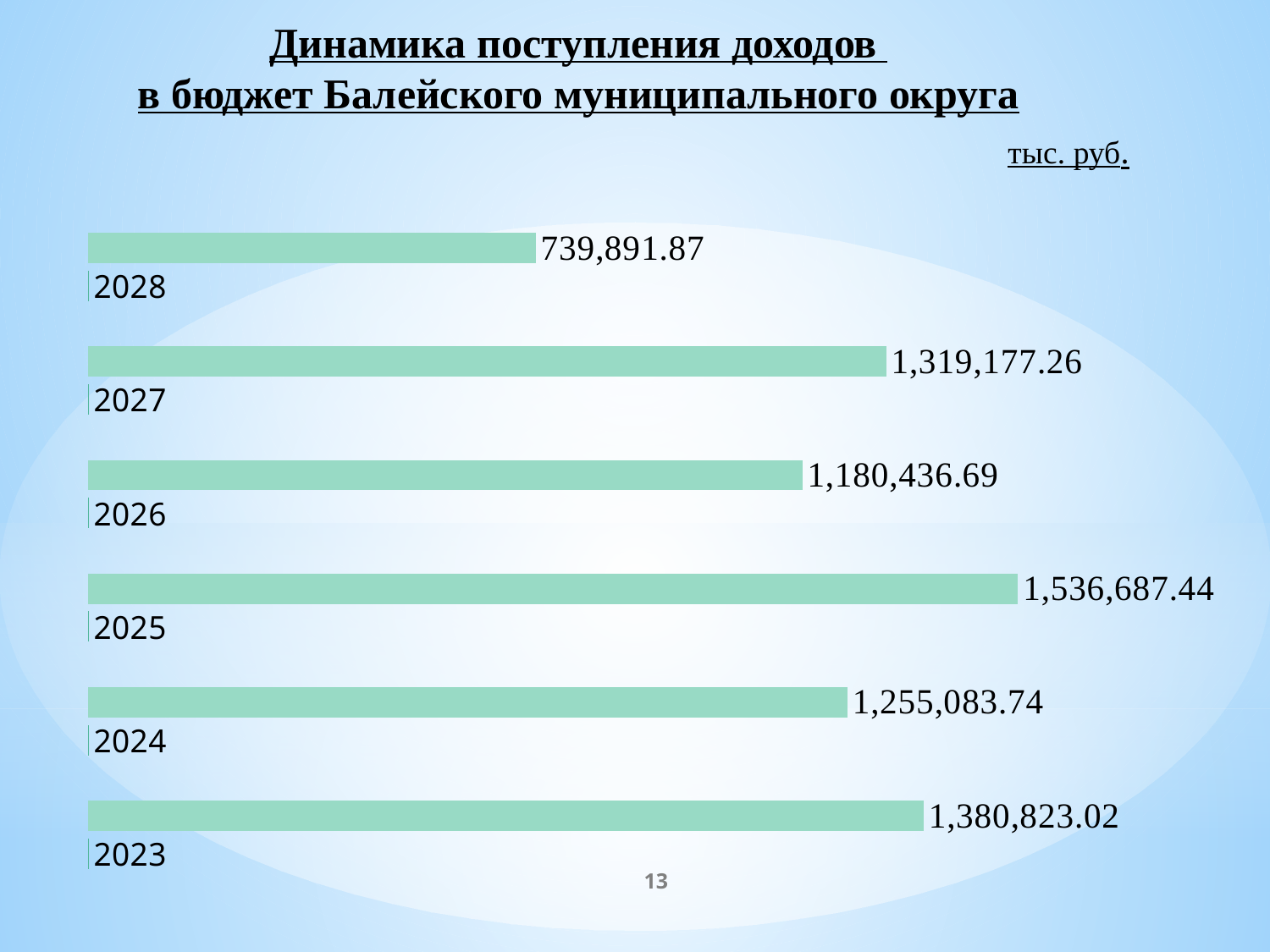
Does the value rise or fall from 2027 to 2028? fall Which year has the highest value? 2025 What is the difference between the values for 2023 and 2024? 125,739.28 What kind of chart is shown on the slide? bar chart What unit is indicated for the values in the chart? тыс. руб. Which is larger, the value for 2024 or the value for 2027? 2027 What is the value for 2023? 1,380,823.02 How many years are shown in the chart? 6 What is the value for 2028? 739,891.87 What is the difference between the values for 2025 and 2026? 356,250.75 What is the value for 2025? 1,536,687.44 Which year has the lowest value? 2028